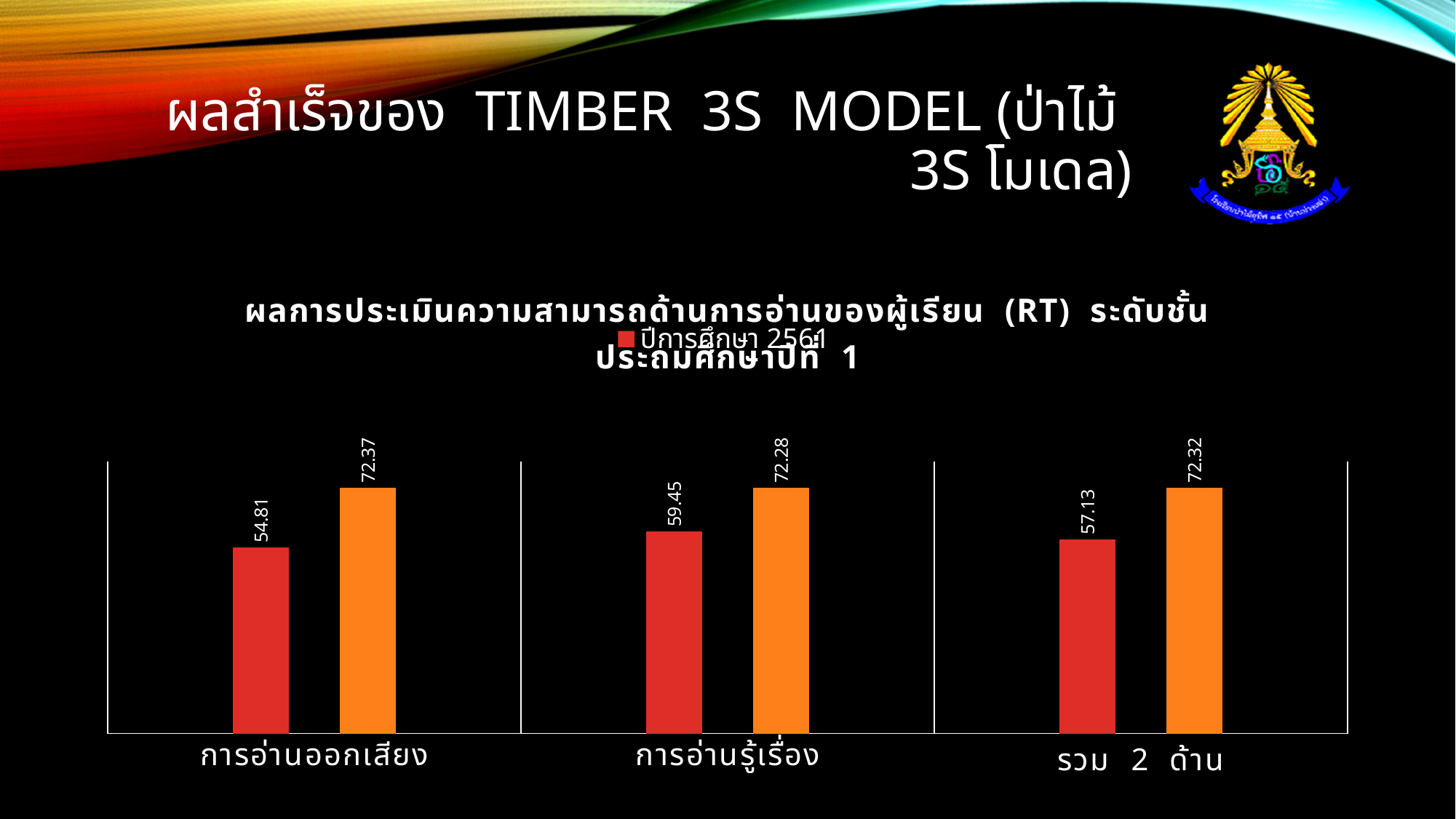
For การอ่านออกเสียง, what is the difference between the orange bar and the red bar? 17.56 What is the value of the orange bar for การอ่านรู้เรื่อง? 72.28 How many categories are shown on the x axis of the chart? 3 What is the value of the orange bar for รวม 2 ด้าน? 72.32 Among the red (ปีการศึกษา 2561) bars, which category has the highest value? การอ่านรู้เรื่อง What type of chart is shown on the slide? Bar chart For รวม 2 ด้าน, what is the difference between the orange bar and the red bar? 15.19 Which red bar is larger: การอ่านรู้เรื่อง or รวม 2 ด้าน? การอ่านรู้เรื่อง Among the red (ปีการศึกษา 2561) bars, which category has the lowest value? การอ่านออกเสียง Among the orange bars, which category has the highest value? การอ่านออกเสียง What is the value of the ปีการศึกษา 2561 (red) bar for การอ่านออกเสียง? 54.81 What is the value of the ปีการศึกษา 2561 (red) bar for รวม 2 ด้าน? 57.13